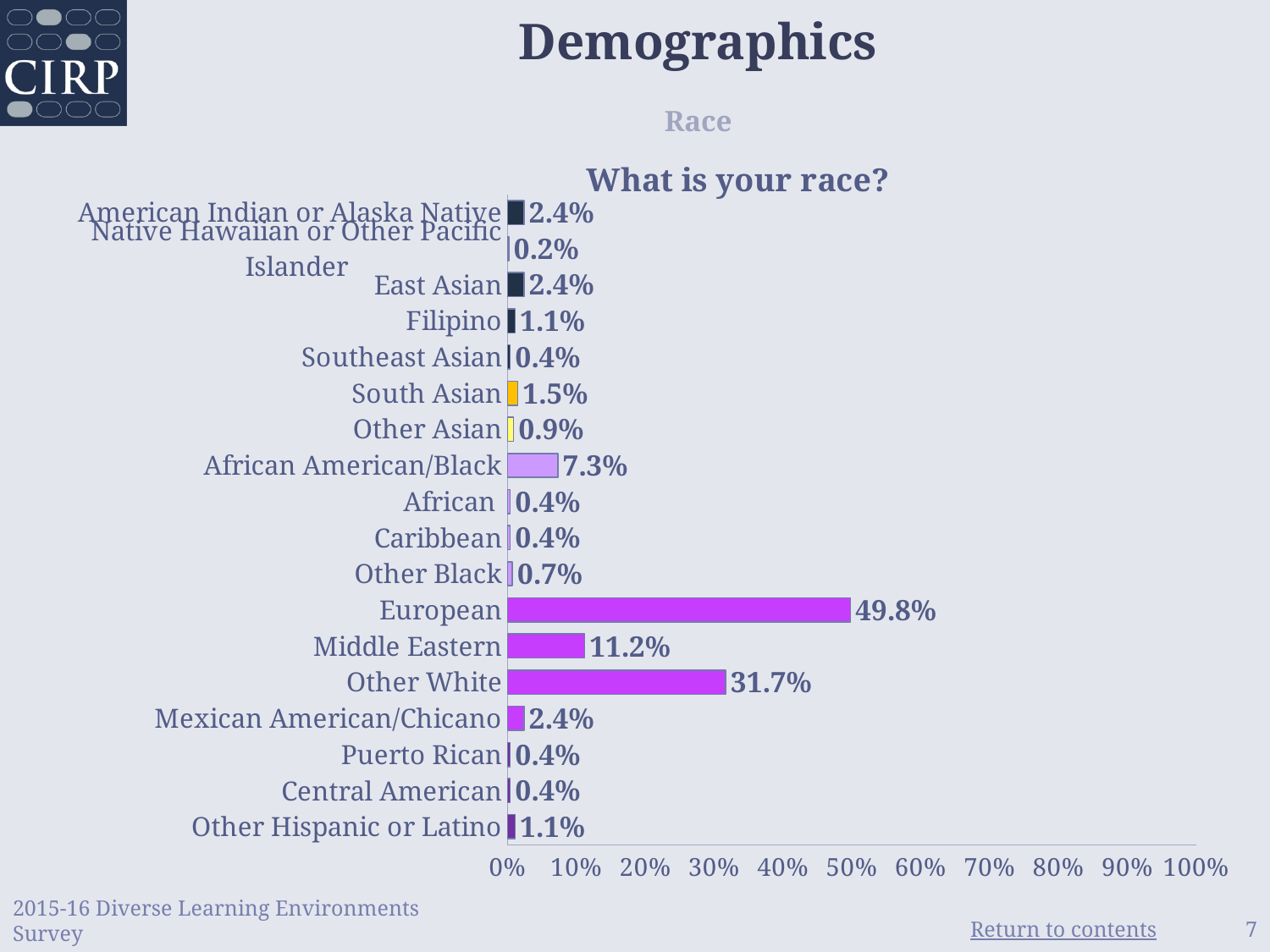
Is the value for Other White greater or less than 30%? greater How many race categories are shown in the chart? 18 Which race category has the lowest percentage? Native Hawaiian or Other Pacific Islander Which race category has the highest percentage? European What is the value for Native Hawaiian or Other Pacific Islander? 0.2% What is the difference between the Middle Eastern and African American/Black percentages? 3.9% Which is larger, the value for Middle Eastern or the value for African American/Black? Middle Eastern What is the difference between the European and Other White percentages? 18.1% What is the value shown for Other White? 31.7% What type of chart is used to show the race data? Bar chart What percentage is shown for African American/Black? 7.3% What percentage of respondents identified as European? 49.8%